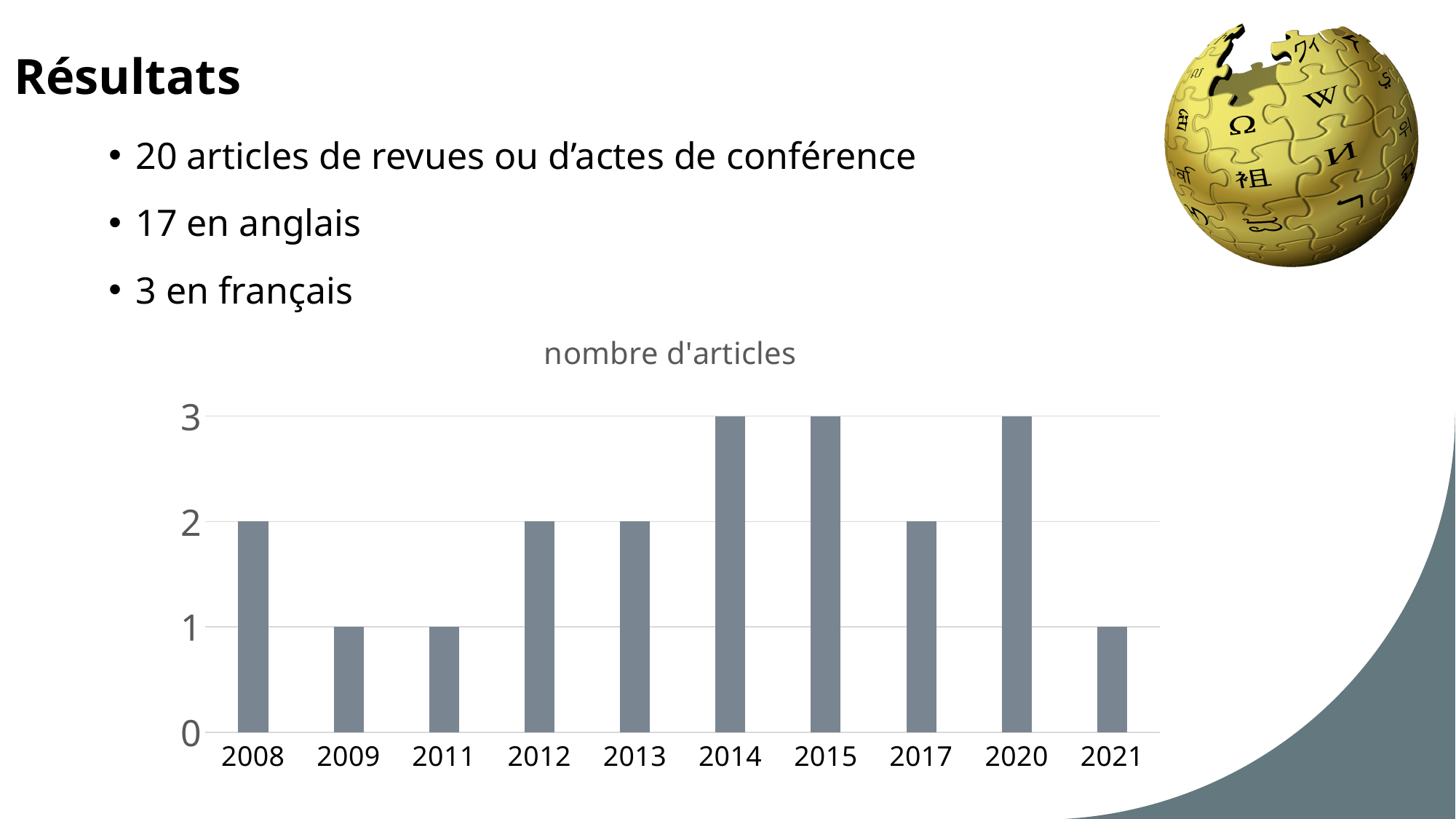
What is the value for 2009 in the chart? 1 What kind of chart is shown on the slide? bar chart What is the difference between the values for 2015 and 2011? 2 What is the value for 2014 in the chart? 3 How many years are shown on the x axis of the chart? 10 What is the value for 2021 in the chart? 1 What is the value for 2017 in the chart? 2 What is the title of the chart? nombre d'articles Which has the larger value, 2009 or 2008? 2008 What is the value for 2008 in the chart? 2 What is the difference between the values for 2020 and 2013? 1 Which has the larger value, 2014 or 2012? 2014